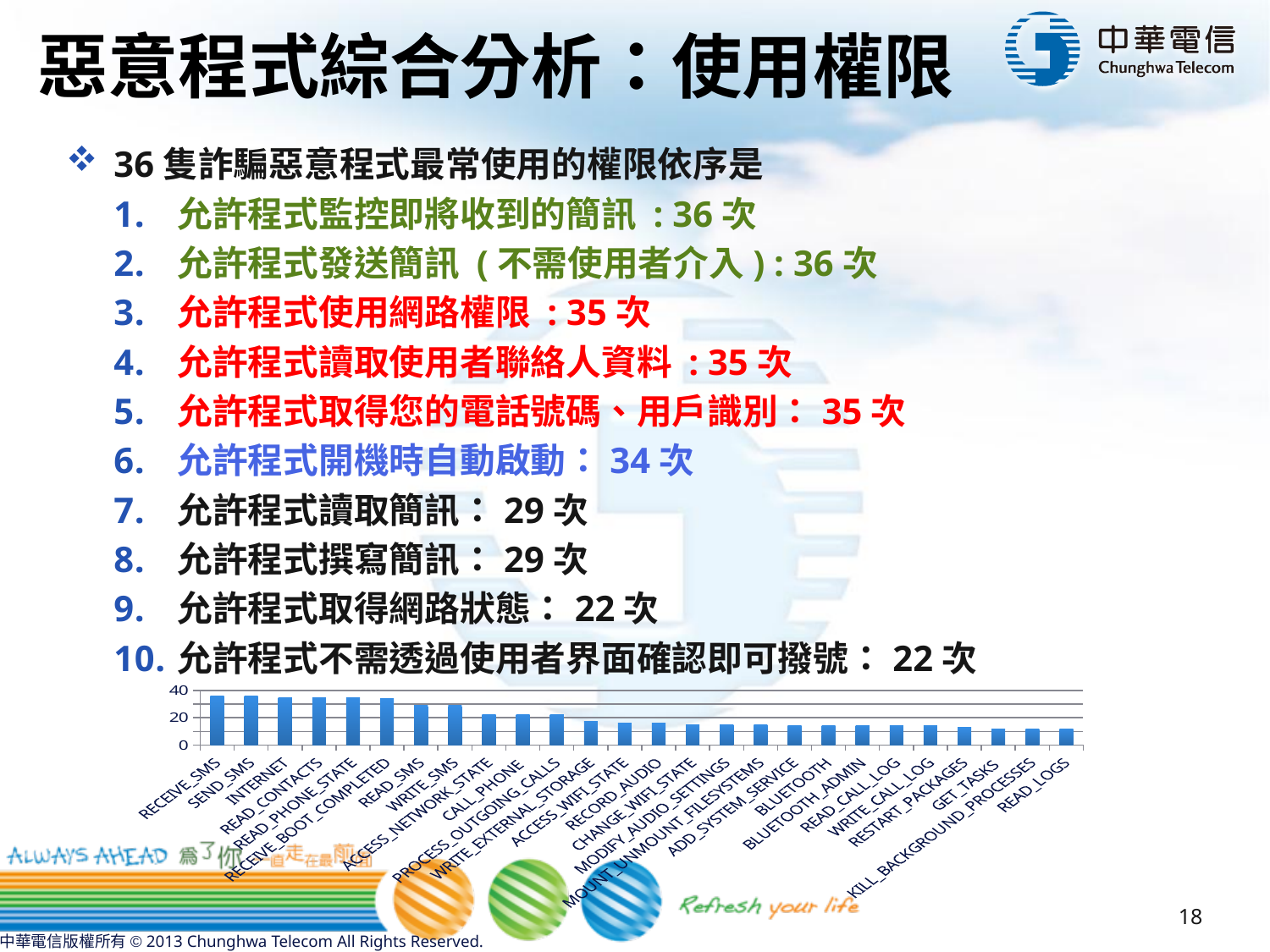
Is the value for READ_LOGS in the bar chart greater or less than 20? less In the bar chart, which has the larger value: READ_SMS or BLUETOOTH_ADMIN? READ_SMS In the bar chart, which has the larger value: RECEIVE_SMS or READ_LOGS? RECEIVE_SMS What kind of chart is shown at the bottom of the slide? bar chart Is the value for GET_TASKS in the bar chart greater or less than 20? less Is the value for BLUETOOTH in the bar chart greater or less than 20? less Do the bar values generally rise or fall moving from left to right along the x axis? fall How many categories (permissions) are plotted along the x axis of the bar chart? 26 What is the highest tick value shown on the vertical axis of the bar chart? 40